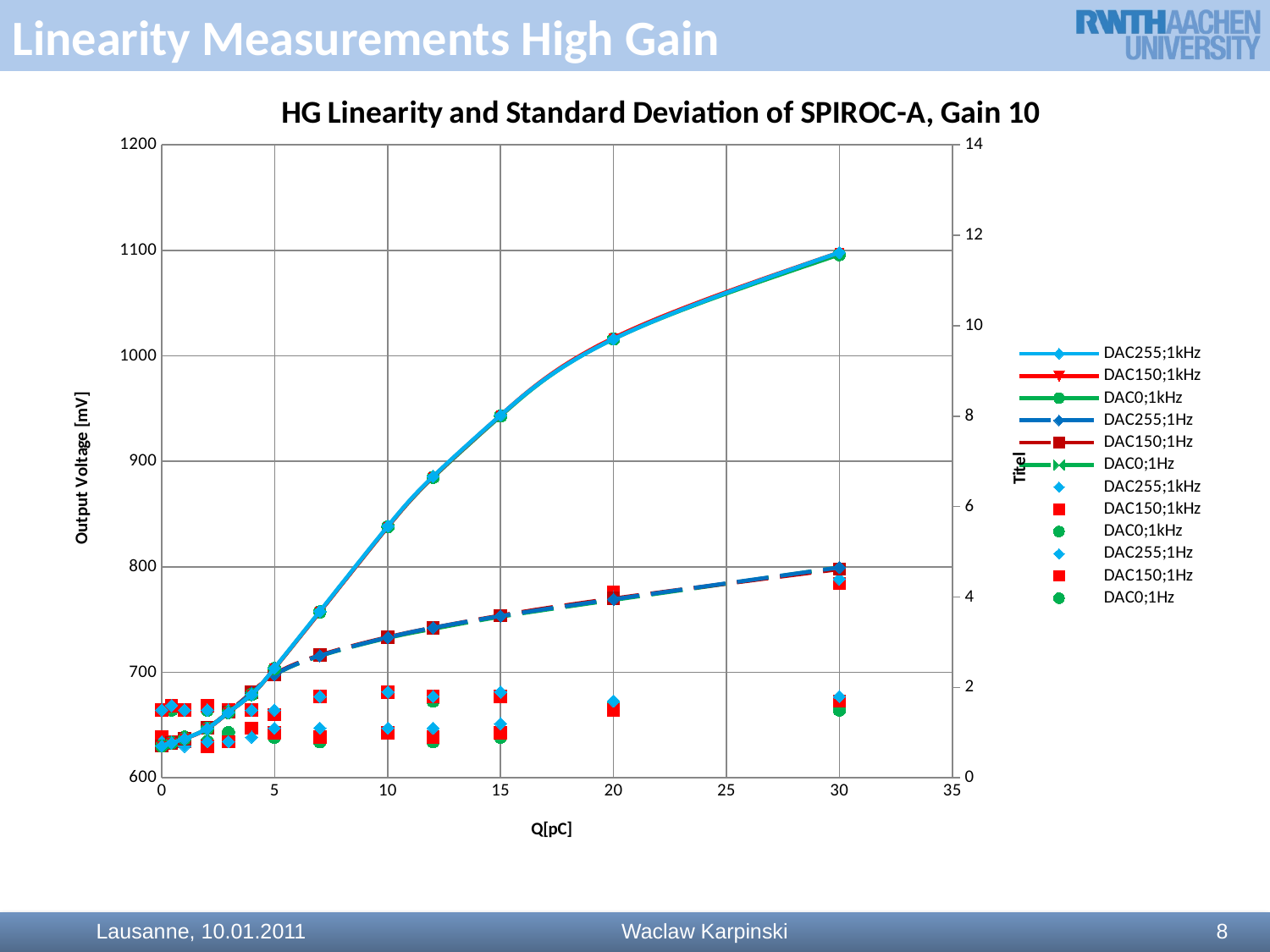
Is the output voltage of the DAC255;1kHz line at Q = 5 pC greater or less than 800 mV? less Is the output voltage of the DAC255;1kHz line at Q = 30 pC greater or less than 1000 mV? greater Is the output voltage of the DAC255;1Hz dashed line at Q = 10 pC greater or less than 700 mV? greater What is the label of the x axis? Q[pC] What is the title of the chart? HG Linearity and Standard Deviation of SPIROC-A, Gain 10 What is the maximum value shown on the left y axis? 1200 How many series does the chart legend list? 12 Does the output voltage of the DAC255;1kHz line rise or fall as Q increases from 0 to 30 pC? rise At Q = 30 pC, which has the higher output voltage: the DAC255;1kHz line or the DAC255;1Hz dashed line? DAC255;1kHz What kind of chart is shown on the slide? line chart